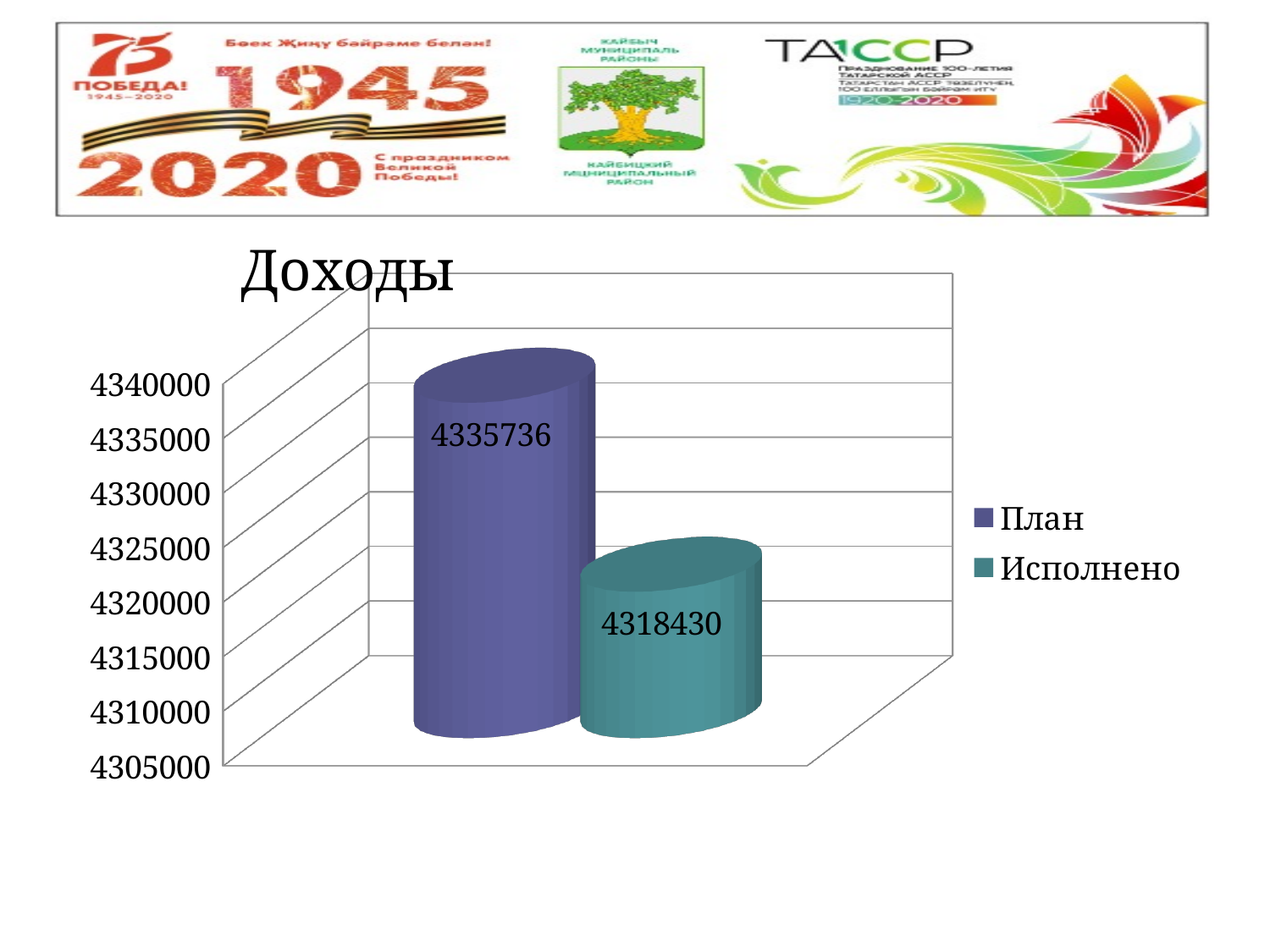
What is the value for План in the Доходы chart? 4335736 What is the value for Исполнено in the Доходы chart? 4318430 What kind of chart is shown on the slide? bar chart Which series has the lower value in the Доходы chart? Исполнено Is the value for План greater or less than 4330000? greater How many series does the legend of the Доходы chart list? 2 What colour is the bar for Исполнено in the Доходы chart? teal What is the difference between the План and Исполнено values in the Доходы chart? 17306 Is the value for План larger or smaller than the value for Исполнено? larger Is the value for Исполнено greater or less than 4320000? less What is the title of the chart on the slide? Доходы Which series has the higher value in the Доходы chart? План